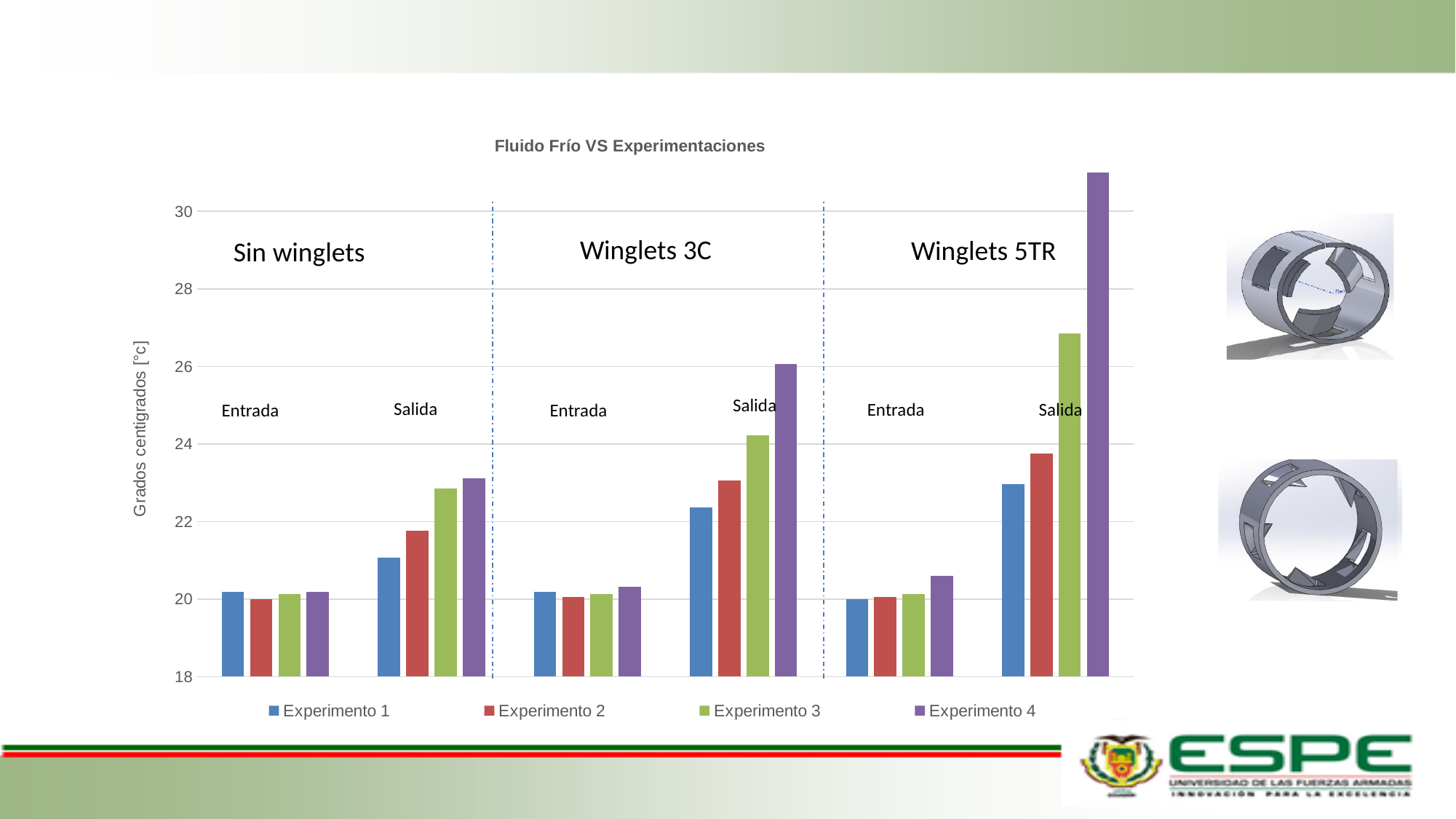
Under Winglets 5TR, do the values rise or fall from Entrada to Salida? rise Is the value for Experimento 3 at Salida under Sin winglets greater or less than 24? less What kind of chart is shown on the slide? Bar chart Which series has the highest bar in the whole chart? Experimento 4 Is the value for Experimento 3 at Salida under Winglets 5TR greater or less than 26? greater Is the value for Experimento 4 at Salida under Winglets 5TR greater or less than 30? greater Which is larger: Experimento 4 at Salida under Winglets 5TR or Experimento 4 at Salida under Winglets 3C? Experimento 4 at Salida under Winglets 5TR Within the Salida group under Winglets 5TR, which series has the lowest bar? Experimento 1 How many series does the legend list? 4 What is the label of the vertical axis? Grados centigrados [°c] How many Entrada/Salida bar groups are plotted in the chart? 6 What is the title of the chart? Fluido Frío VS Experimentaciones